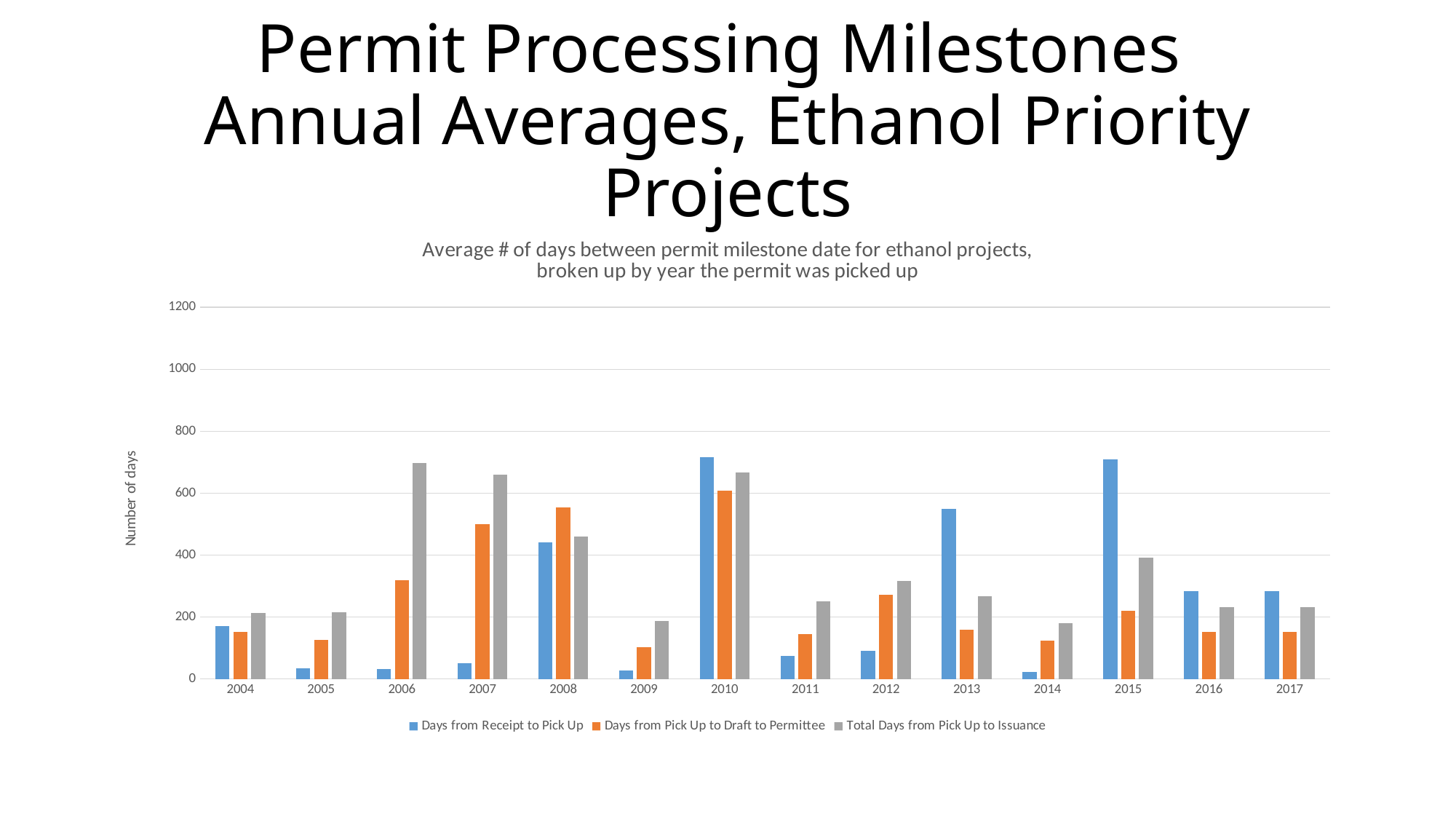
Is the value for Days from Receipt to Pick Up in 2014 greater or less than 200? less In 2008, which is larger: Days from Pick Up to Draft to Permittee or Days from Receipt to Pick Up? Days from Pick Up to Draft to Permittee How many years are shown on the x axis? 14 In which year is Days from Pick Up to Draft to Permittee highest? 2010 In 2010, which is larger: Days from Receipt to Pick Up or Days from Pick Up to Draft to Permittee? Days from Receipt to Pick Up Is the value for Days from Pick Up to Draft to Permittee in 2007 greater or less than 400? greater Is the value for Days from Receipt to Pick Up in 2013 greater or less than 400? greater What kind of chart is shown on the slide? bar chart How many series does the legend list? 3 What is the label on the vertical axis of the chart? Number of days